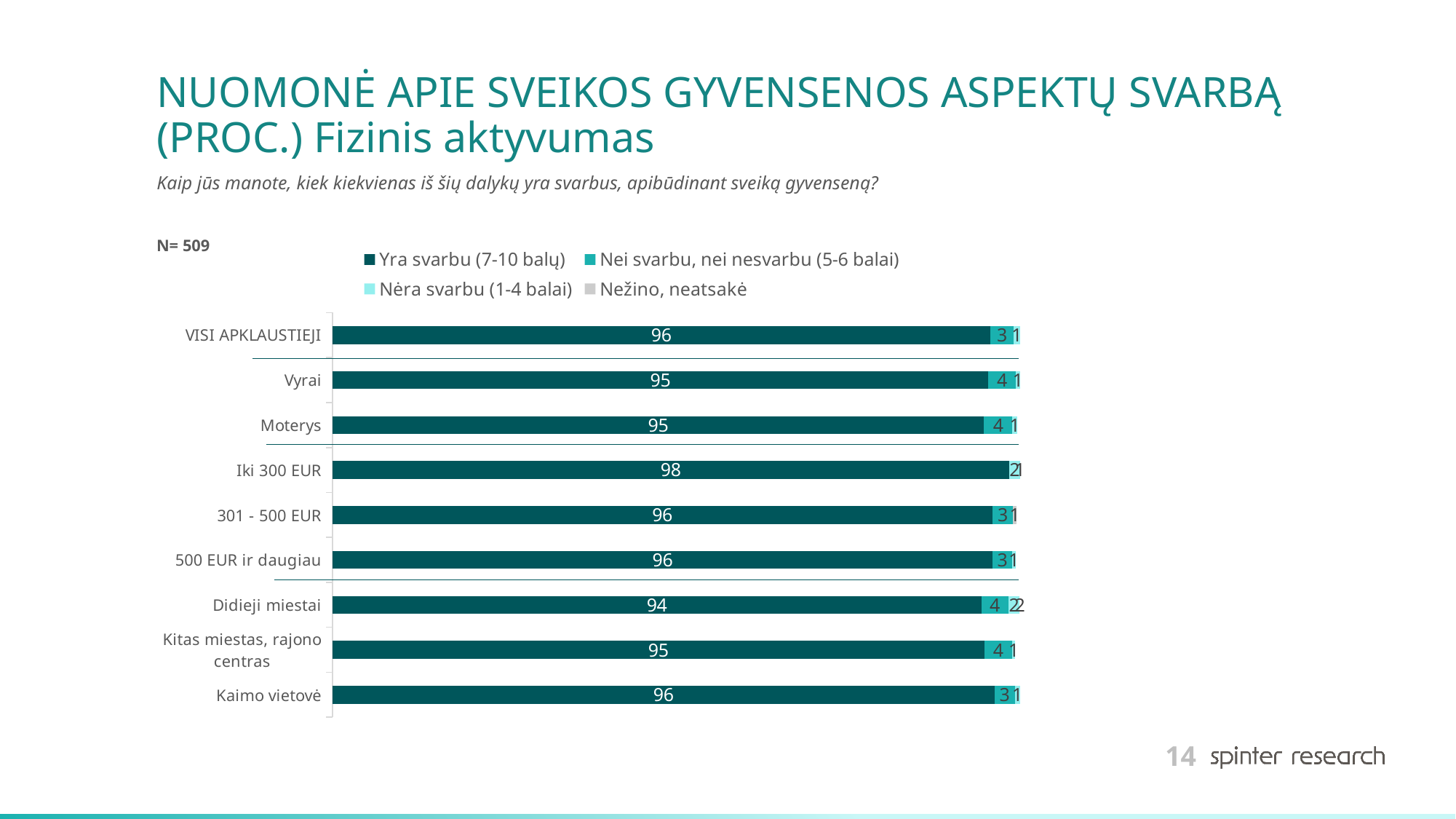
How many series does the legend list? 4 What kind of chart is shown on the slide? Stacked bar chart What is the value of "Yra svarbu (7-10 balų)" for Didieji miestai? 94 How many categories are shown on the chart? 9 Which category has the lowest value for "Yra svarbu (7-10 balų)"? Didieji miestai Which category has the highest value for "Yra svarbu (7-10 balų)"? Iki 300 EUR What is the difference between the "Yra svarbu (7-10 balų)" values for Iki 300 EUR and Didieji miestai? 4 What is the value of "Yra svarbu (7-10 balų)" for Iki 300 EUR? 98 What is the value of "Yra svarbu (7-10 balų)" for VISI APKLAUSTIEJI? 96 What sample size (N) is stated on the slide? N= 509 Which has a larger "Yra svarbu (7-10 balų)" value, Kaimo vietovė or Moterys? Kaimo vietovė What is the value of "Nei svarbu, nei nesvarbu (5-6 balai)" for Vyrai? 4